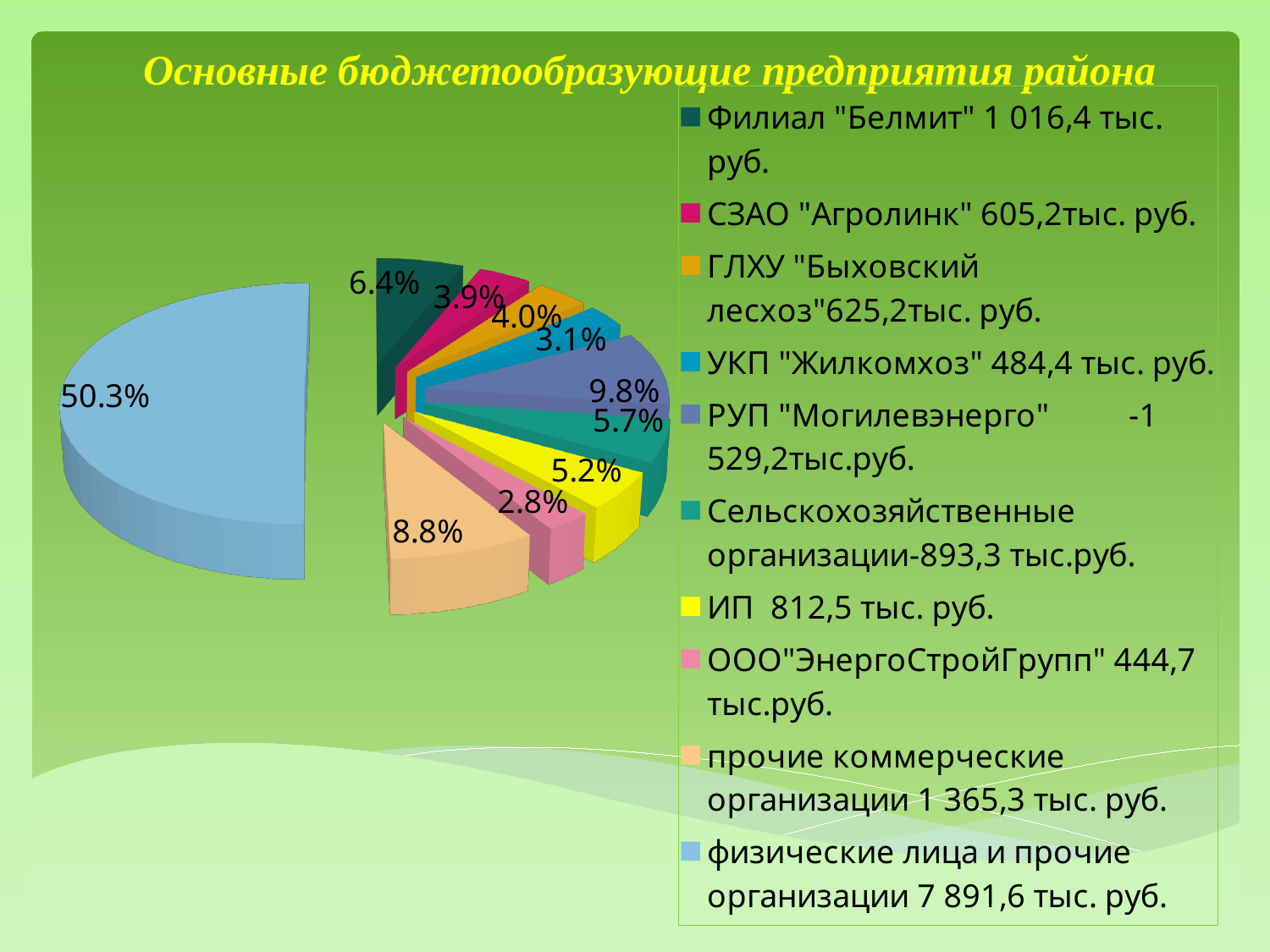
Which has the larger share: ИП or Сельскохозяйственные организации? Сельскохозяйственные организации What is the difference in percentage points between the share of "физические лица и прочие организации" and the share of РУП "Могилевэнерго"? 40.5 What percentage share is shown for Филиал "Белмит"? 6.4% Which category has the largest slice of the pie? физические лица и прочие организации What kind of chart is shown on the slide? pie chart What percentage share is shown for "физические лица и прочие организации"? 50.3% According to the legend, what amount in тыс. руб. is given for УКП "Жилкомхоз"? 484,4 тыс. руб. What percentage share is shown for "прочие коммерческие организации"? 8.8% How many categories does the legend of the pie chart list? 10 What percentage share is shown for РУП "Могилевэнерго"? 9.8% What is the title of the chart on the slide? Основные бюджетообразующие предприятия района Which category has the smallest slice of the pie? ООО"ЭнергоСтройГрупп"